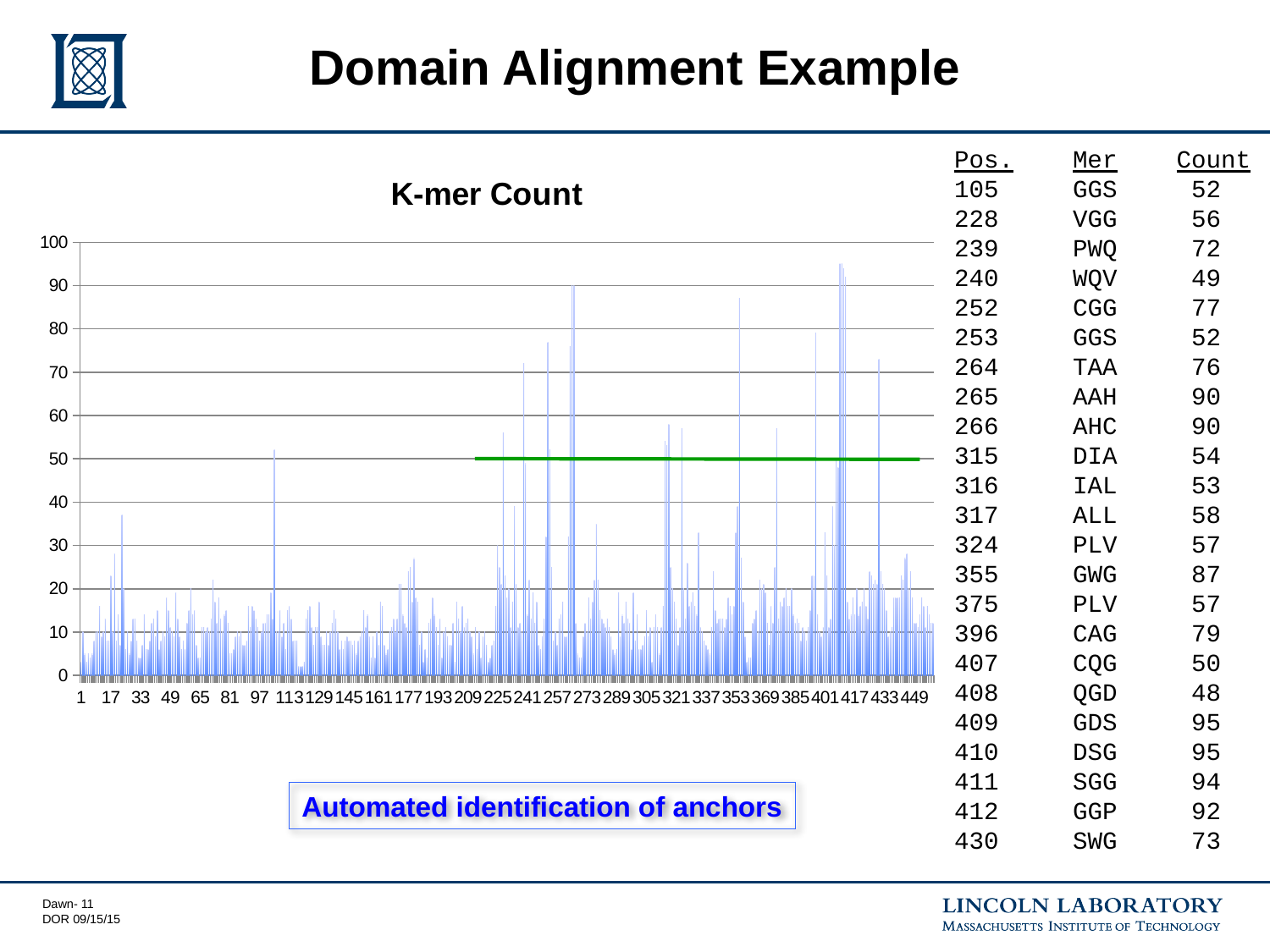
What kind of chart is shown on the slide? bar chart Is the value of the tallest bar between the x-axis labels 97 and 113 greater or less than 60? less Is the value of the tallest bar between the x-axis labels 17 and 33 greater or less than 30? greater What is the title of the chart? K-mer Count Is the value of the tallest bar between the x-axis labels 257 and 273 greater or less than 80? greater What is the highest value shown on the chart's y axis? 100